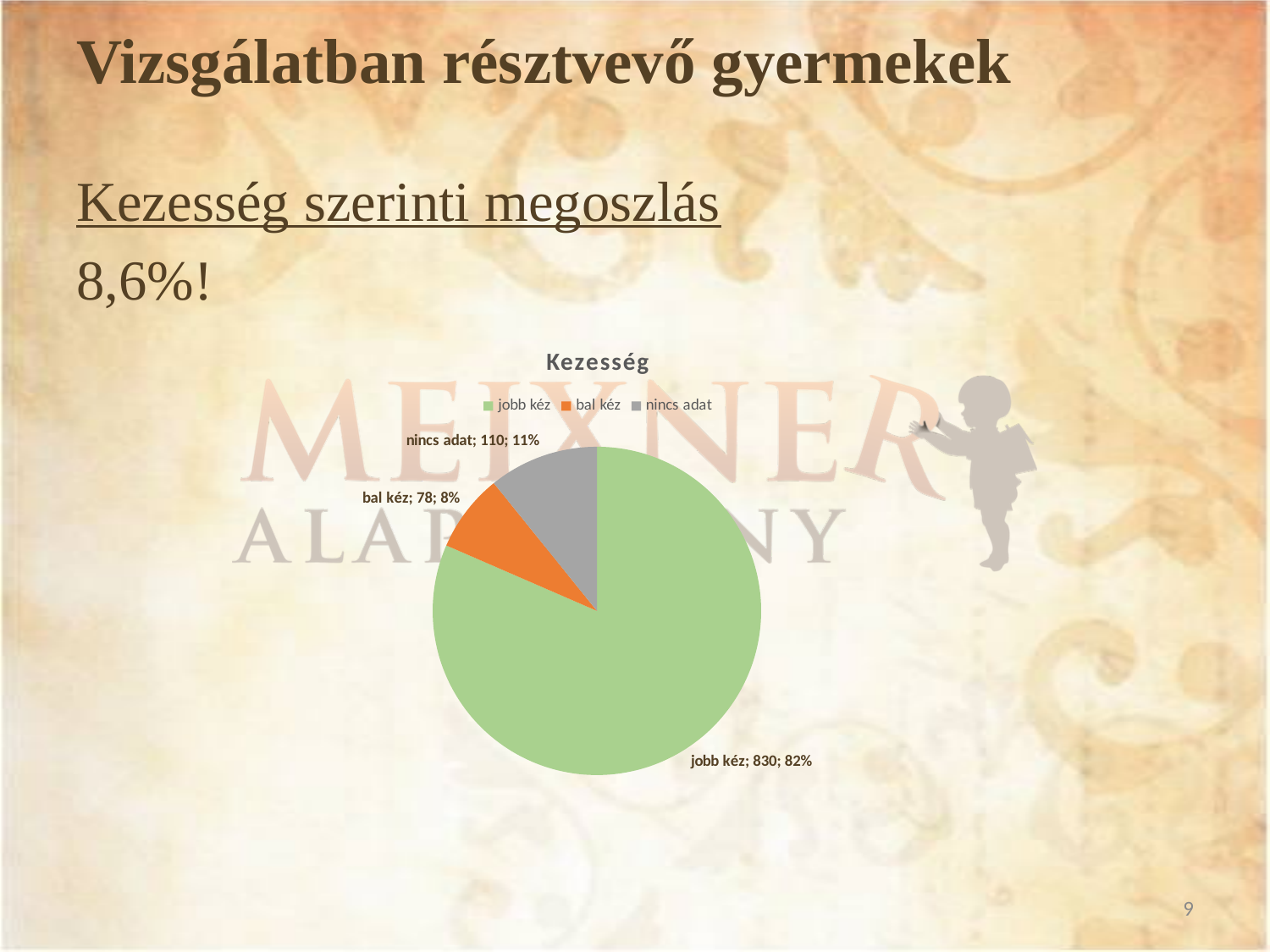
What is the value for 'jobb kéz'? 830 Which category has the smallest slice? bal kéz What share of the pie does 'nincs adat' represent? 11% What is the value for 'bal kéz'? 78 Which category has the largest slice? jobb kéz What is the value for 'nincs adat'? 110 What share of the pie does 'jobb kéz' represent? 82% What is the difference between the values for 'nincs adat' and 'bal kéz'? 32 What is the title of the chart? Kezesség How many entries does the legend list? 3 What kind of chart is shown on the slide? pie chart How many slices does the pie chart have? 3